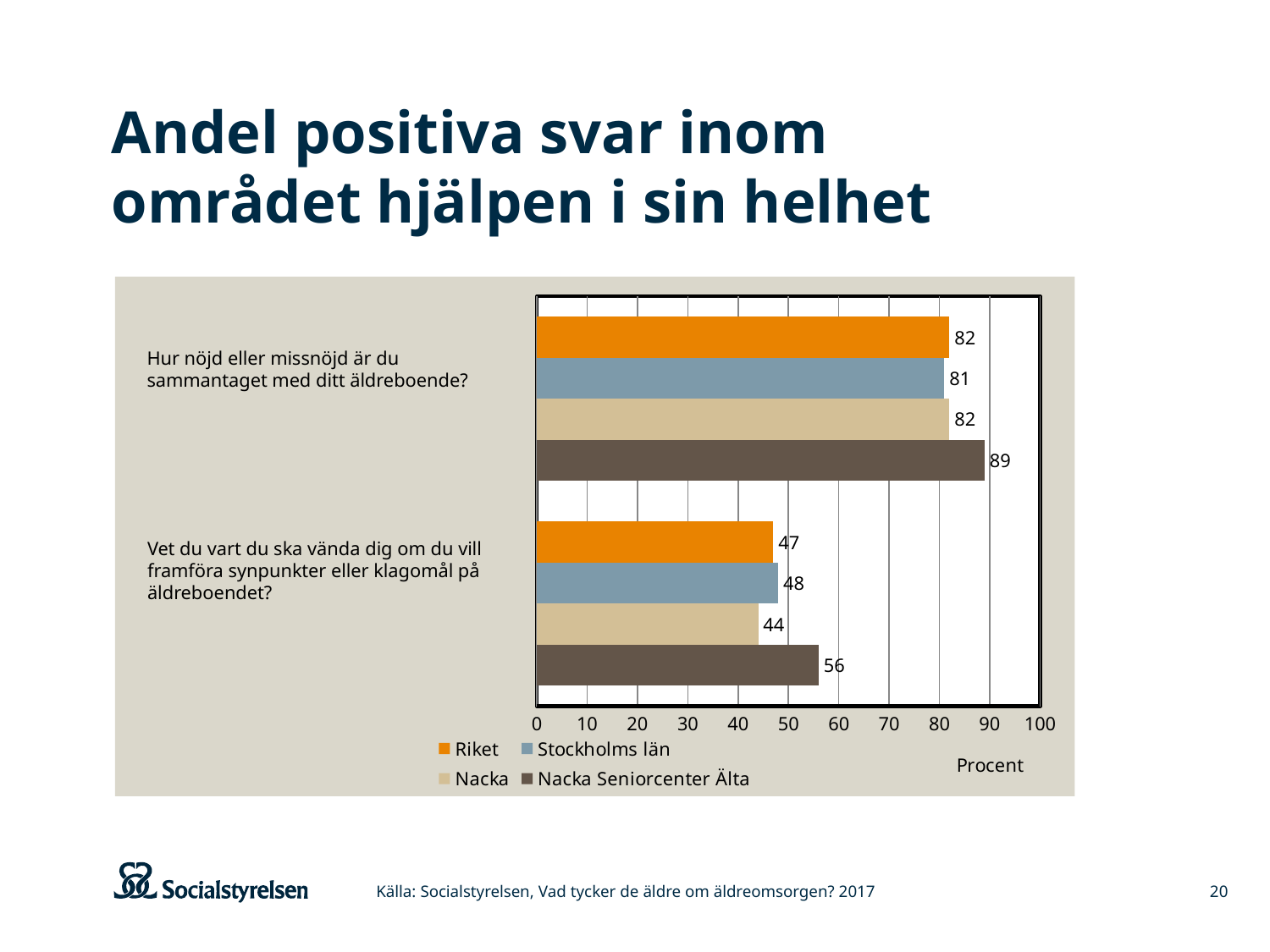
What unit is shown on the horizontal axis label? Procent Which series has the highest value on the question "Vet du vart du ska vända dig om du vill framföra synpunkter eller klagomål på äldreboendet?"? Nacka Seniorcenter Älta What is the value for Nacka on the question "Vet du vart du ska vända dig om du vill framföra synpunkter eller klagomål på äldreboendet?"? 44 How many series does the legend list? 4 Which series has the lowest value on the question "Vet du vart du ska vända dig om du vill framföra synpunkter eller klagomål på äldreboendet?"? Nacka What is the difference between the Nacka Seniorcenter Älta value and the Riket value on the question "Hur nöjd eller missnöjd är du sammantaget med ditt äldreboende?"? 7 Is the value for Nacka Seniorcenter Älta on the question "Vet du vart du ska vända dig om du vill framföra synpunkter eller klagomål på äldreboendet?" greater or less than 50? greater What is the difference between the Nacka Seniorcenter Älta value and the Nacka value on the question "Vet du vart du ska vända dig om du vill framföra synpunkter eller klagomål på äldreboendet?"? 12 What kind of chart is shown on the slide? Bar chart What is the value for Nacka Seniorcenter Älta on the question "Hur nöjd eller missnöjd är du sammantaget med ditt äldreboende?"? 89 What is the value for Riket on the question "Vet du vart du ska vända dig om du vill framföra synpunkter eller klagomål på äldreboendet?"? 47 What is the value for Stockholms län on the question "Hur nöjd eller missnöjd är du sammantaget med ditt äldreboende?"? 81